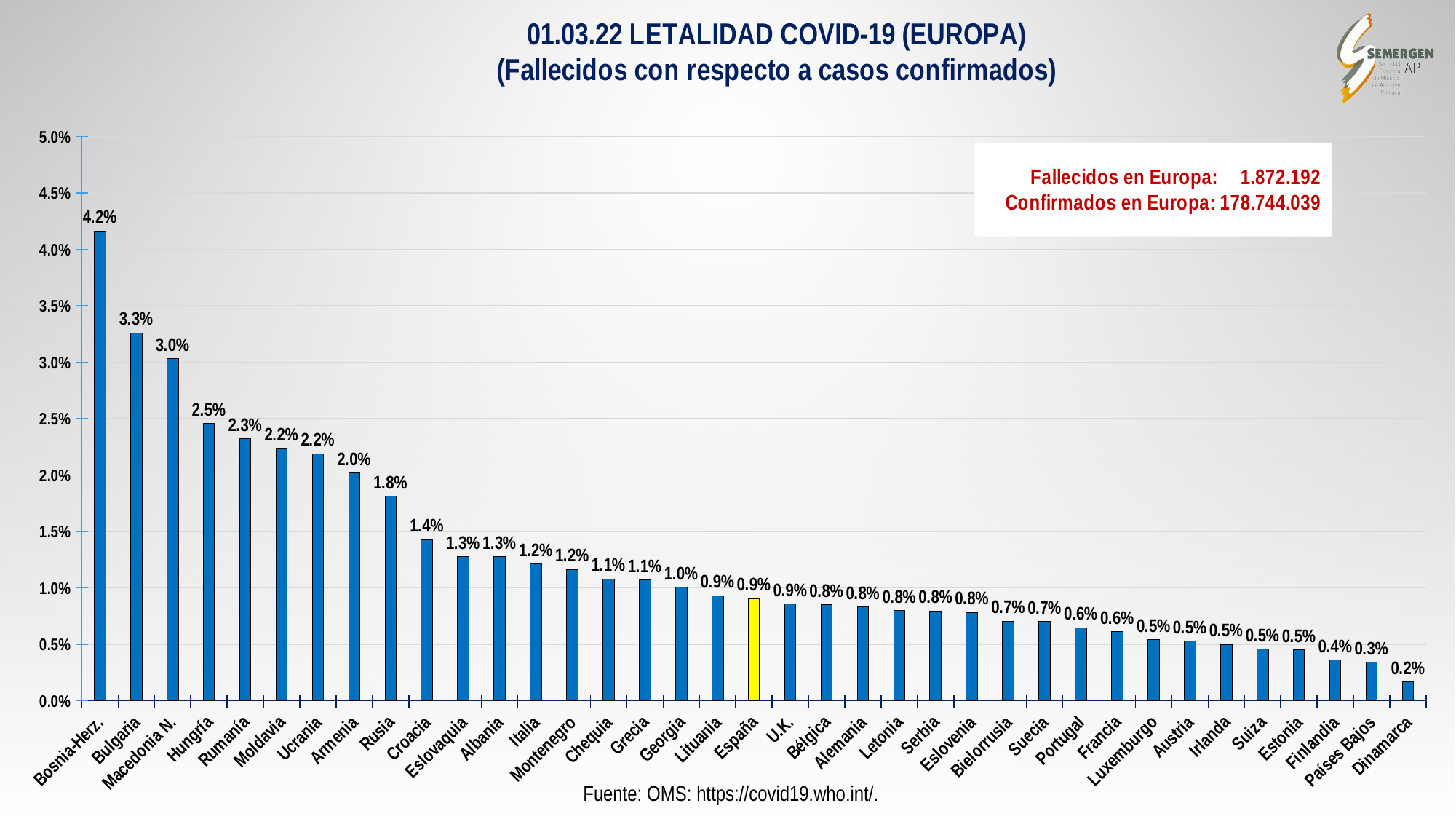
Which is larger, the value for Rusia or the value for Croacia? Rusia What is the difference between the values for Bulgaria and Hungría? 0.8% Which country's bar is highlighted in yellow? España What kind of chart is shown? Bar chart Is the value for Macedonia N. greater or less than 2.5%? greater What is the value for Italia? 1.2% Which country has the highest value? Bosnia-Herz. What is the value for Bosnia-Herz.? 4.2% What is the value for España? 0.9% Which country has the lowest value? Dinamarca What is the value for Dinamarca? 0.2% How many countries are shown on the chart? 37